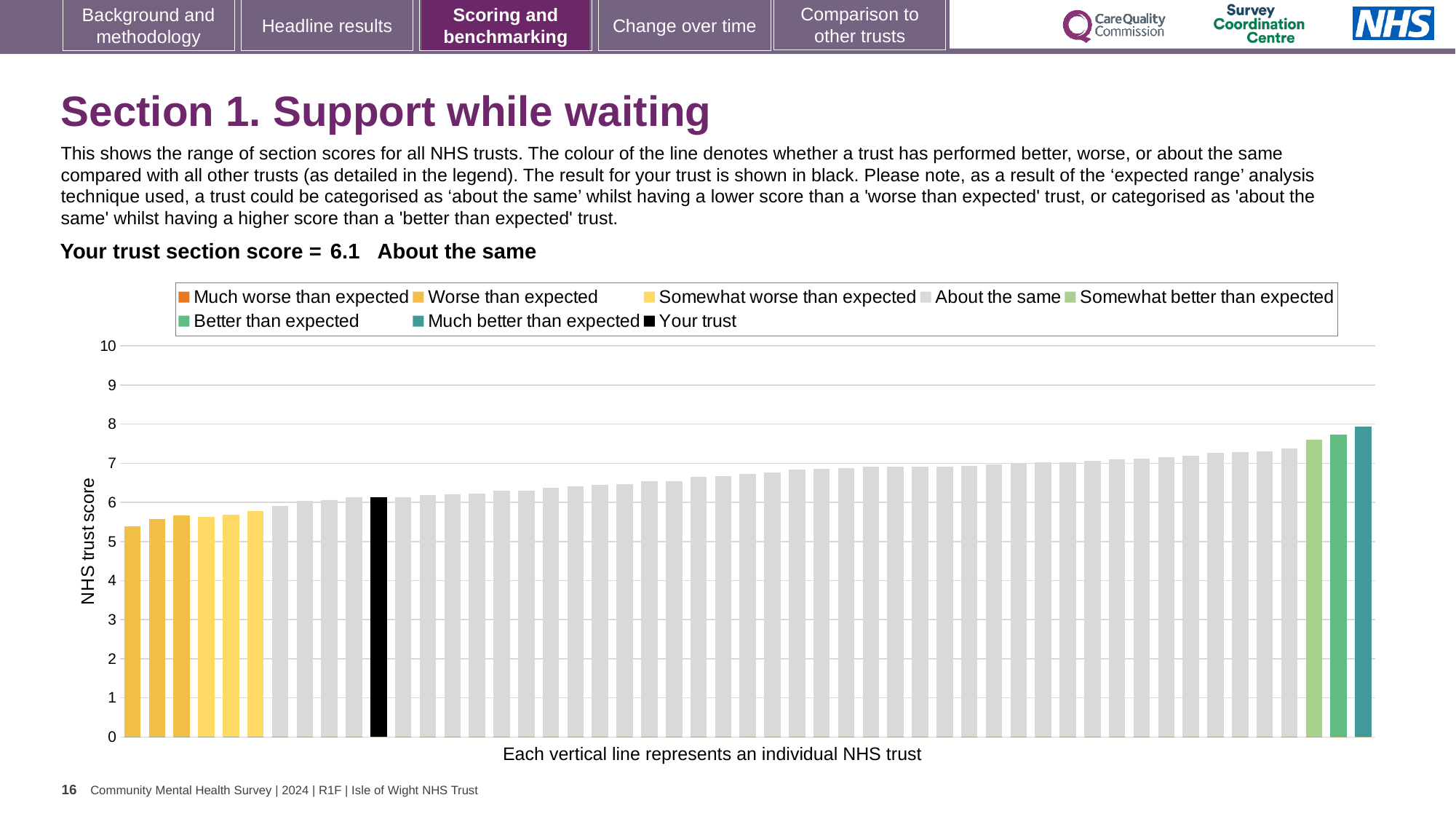
Is the value for your trust greater or less than 5? greater Which legend category does the lowest bar belong to? Worse than expected Which legend category does the highest bar belong to? Much better than expected What is the section score for your trust shown on the slide? 6.1 Is the value of the lowest bar greater or less than 6? less What kind of chart is shown on the slide? bar chart What is the label on the y axis of the chart? NHS trust score Is the value of the highest bar greater or less than 7? greater Do the bar values rise or fall from left to right along the x axis? rise How many bars are coloured as 'Worse than expected'? 3 Which category is your trust placed in for this section? About the same How many entries does the chart legend list? 8